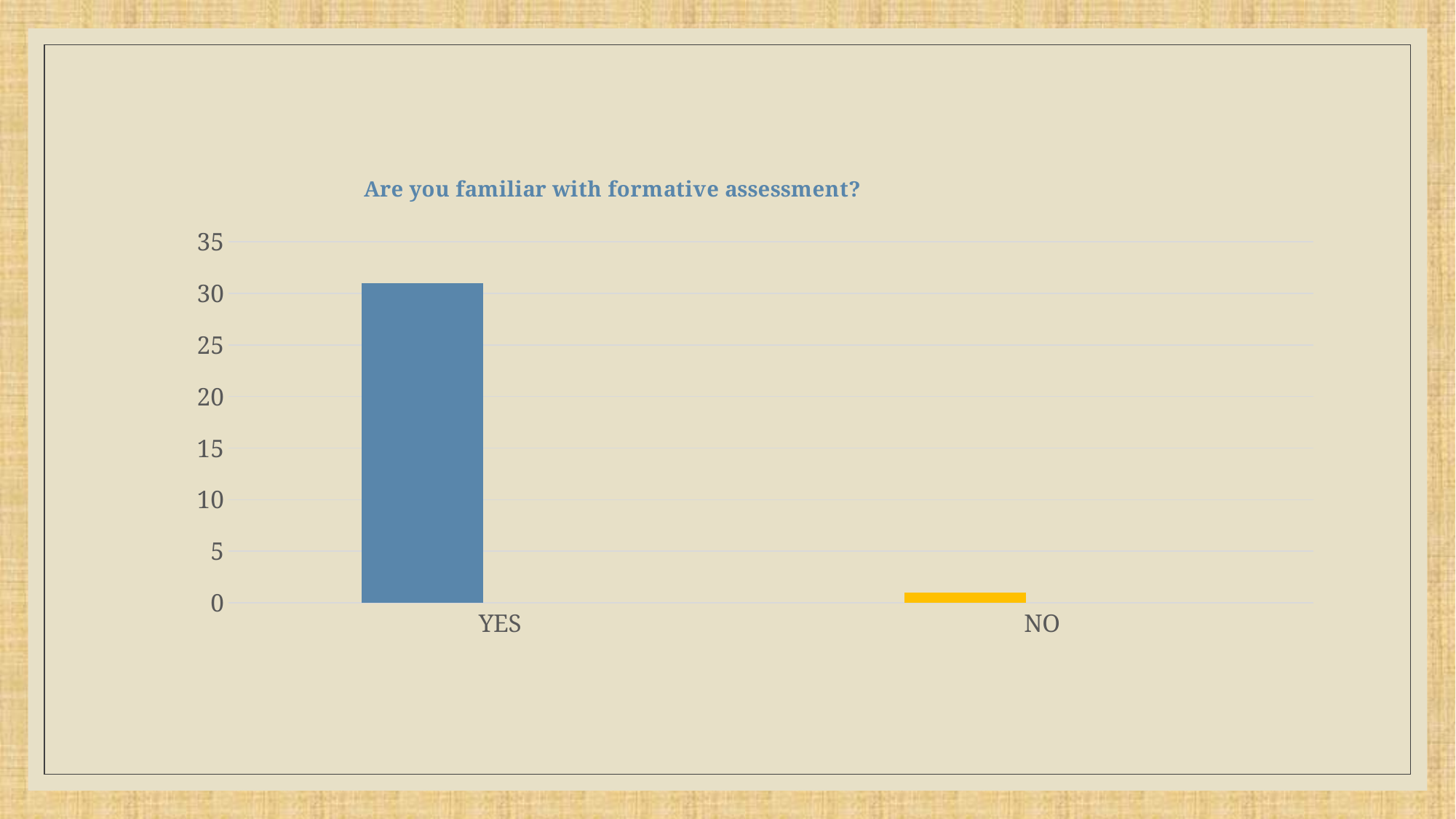
Is the value for NO greater or less than 10? less What is the title of the chart? Are you familiar with formative assessment? Which category has the highest value? YES How many categories are shown on the x axis of the chart? 2 What colour is the bar for YES? blue Which is larger, the value for YES or the value for NO? YES What kind of chart is shown on the slide? bar chart Is the value for NO greater or less than 5? less Which category has the lowest value? NO Is the value for YES greater or less than 35? less Do the values rise or fall from YES to NO along the x axis? fall